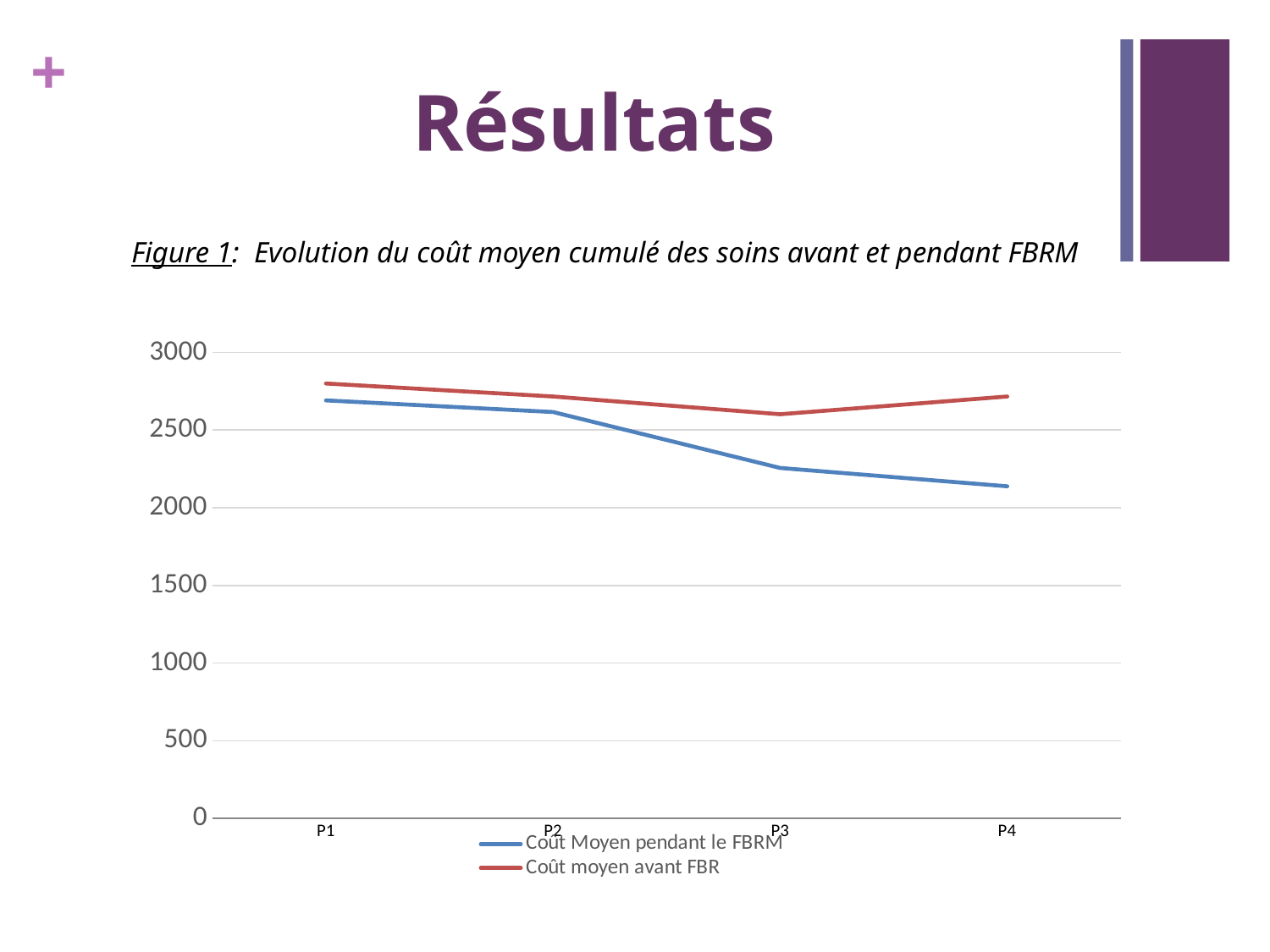
What kind of chart is shown on the slide? line chart At which period is the value for Coût Moyen pendant le FBRM lowest? P4 Do the values for Coût Moyen pendant le FBRM rise or fall from P1 to P4? fall At which period is the value for Coût moyen avant FBR lowest? P3 Is the value for Coût moyen avant FBR at P1 greater or less than 2500? greater Is the value for Coût Moyen pendant le FBRM at P4 greater or less than 2500? less Is the value for Coût moyen avant FBR at P4 greater or less than 2500? greater Which colour is used for the Coût moyen avant FBR series? red How many series does the legend list? 2 At P4, which series has the higher value, Coût Moyen pendant le FBRM or Coût moyen avant FBR? Coût moyen avant FBR How many points are plotted along the x axis for each series? 4